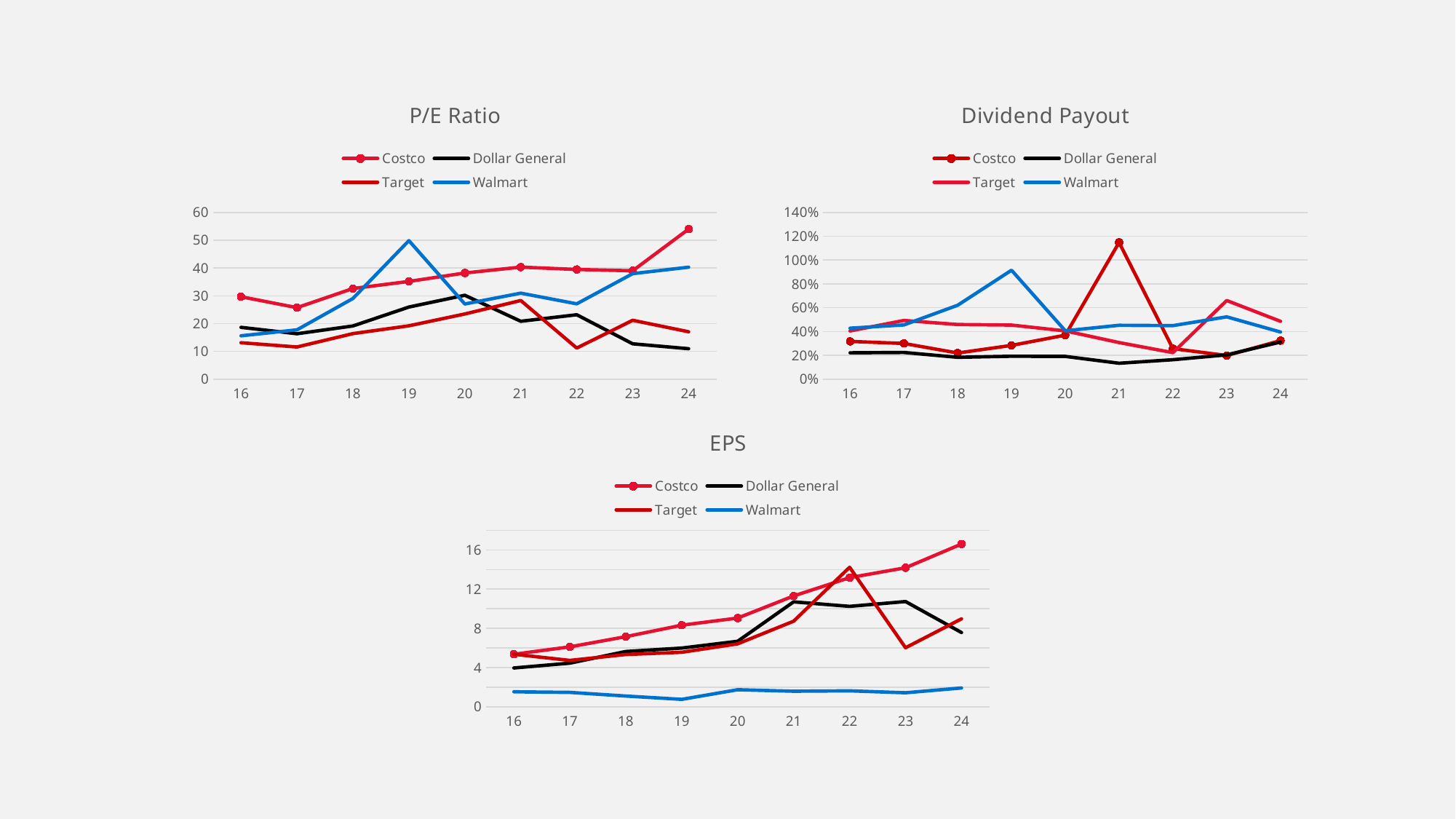
In the EPS chart, do the values for Costco rise or fall from 16 to 24? rise In the P/E Ratio chart, is the value for Costco in 24 greater or less than 50? greater How many series does the legend of the EPS chart list? 4 In the Dividend Payout chart, is the value for Walmart in 19 greater or less than 80%? greater In the P/E Ratio chart, is the value for Dollar General in 24 greater or less than 20? less How many years are shown on the x axis of the Dividend Payout chart? 9 In the EPS chart, which series has the lowest values across all years? Walmart In the Dividend Payout chart, which series has the lowest value in 21? Dollar General What kind of chart is the P/E Ratio chart? line chart In the P/E Ratio chart, which series reaches the highest value in 24? Costco